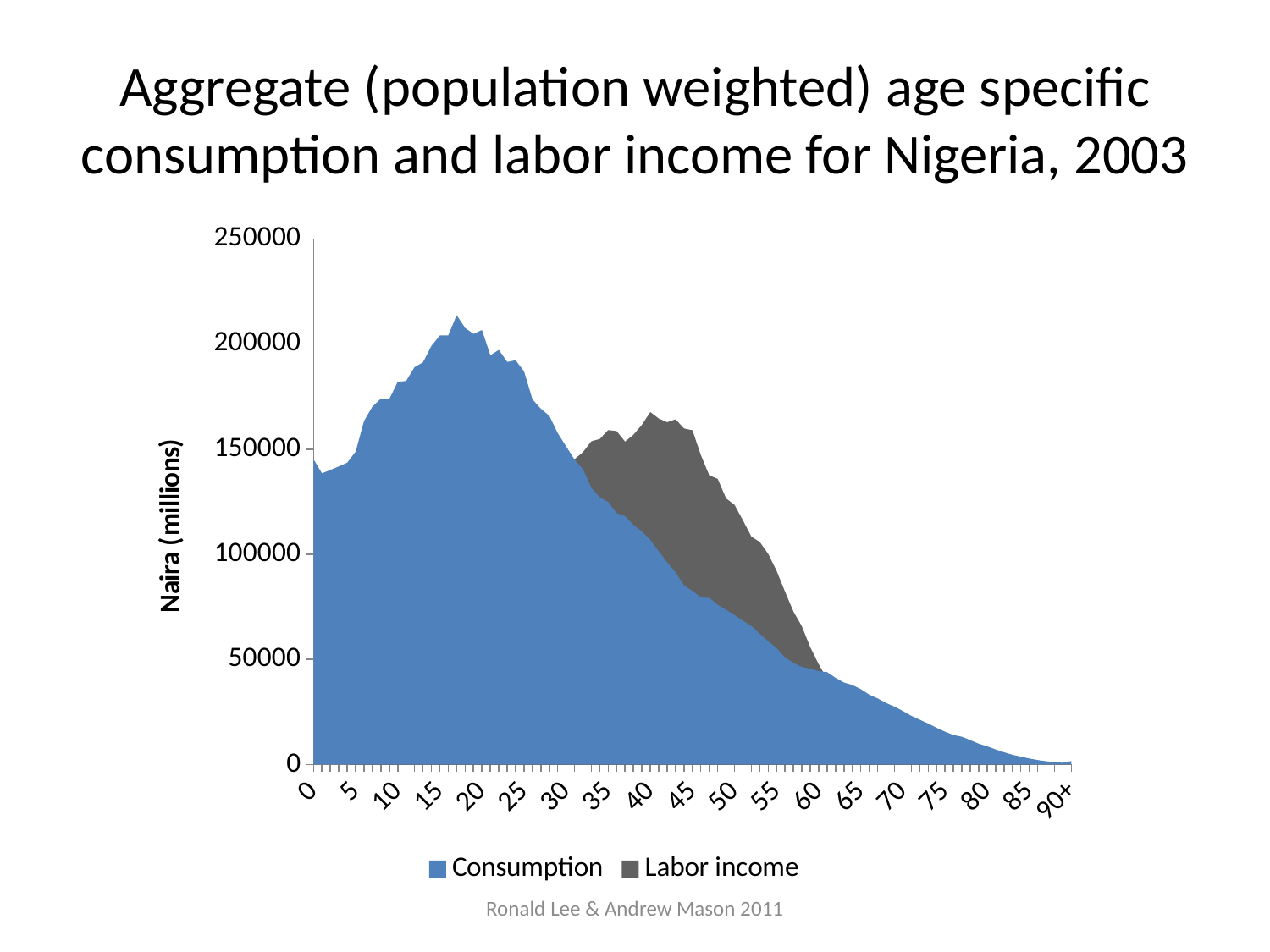
Is the Consumption value at age 35 greater or less than 150000? less Is the Consumption value at age 0 greater or less than 100000? greater What is the highest value shown on the vertical axis? 250000 What is the label on the vertical axis? Naira (millions) Is the Consumption value at age 50 greater or less than 50000? greater Which series reaches the higher peak value, Consumption or Labor income? Consumption Does Consumption rise or fall as age increases from 25 to 85? fall How many series does the legend list? 2 What are the two series named in the legend? Consumption and Labor income What kind of chart is shown on the slide? Area chart